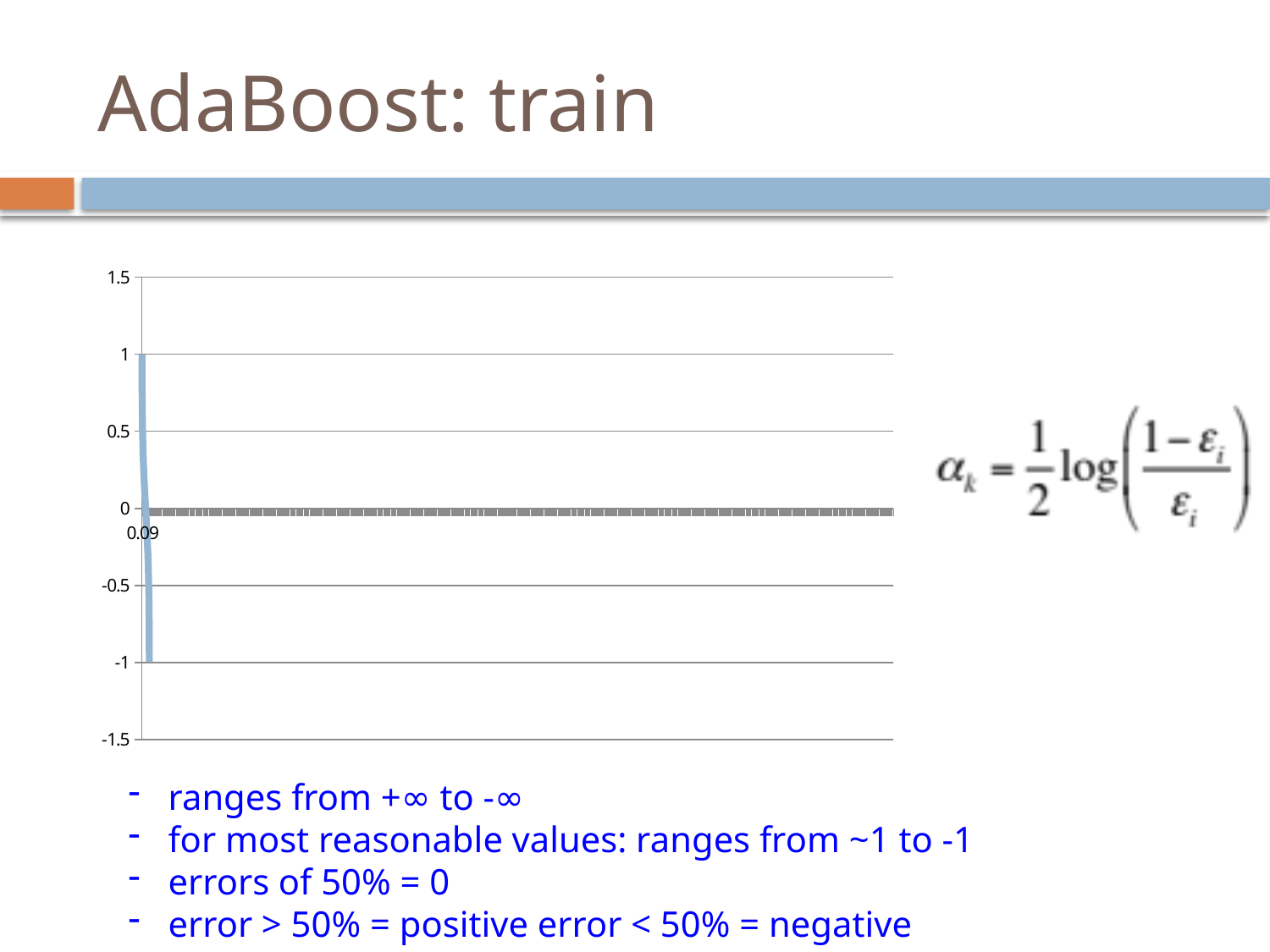
What kind of chart is shown on the slide? line chart Is the value at the top end of the plotted line greater or less than 0.5? greater Is the value at the bottom end of the plotted line greater or less than -0.5? less Do the plotted values rise or fall as you move along the x axis of the chart? fall What is the highest value labelled on the y axis of the chart? 1.5 What is the lowest value labelled on the y axis of the chart? -1.5 What is the only x-axis label printed on the chart? 0.09